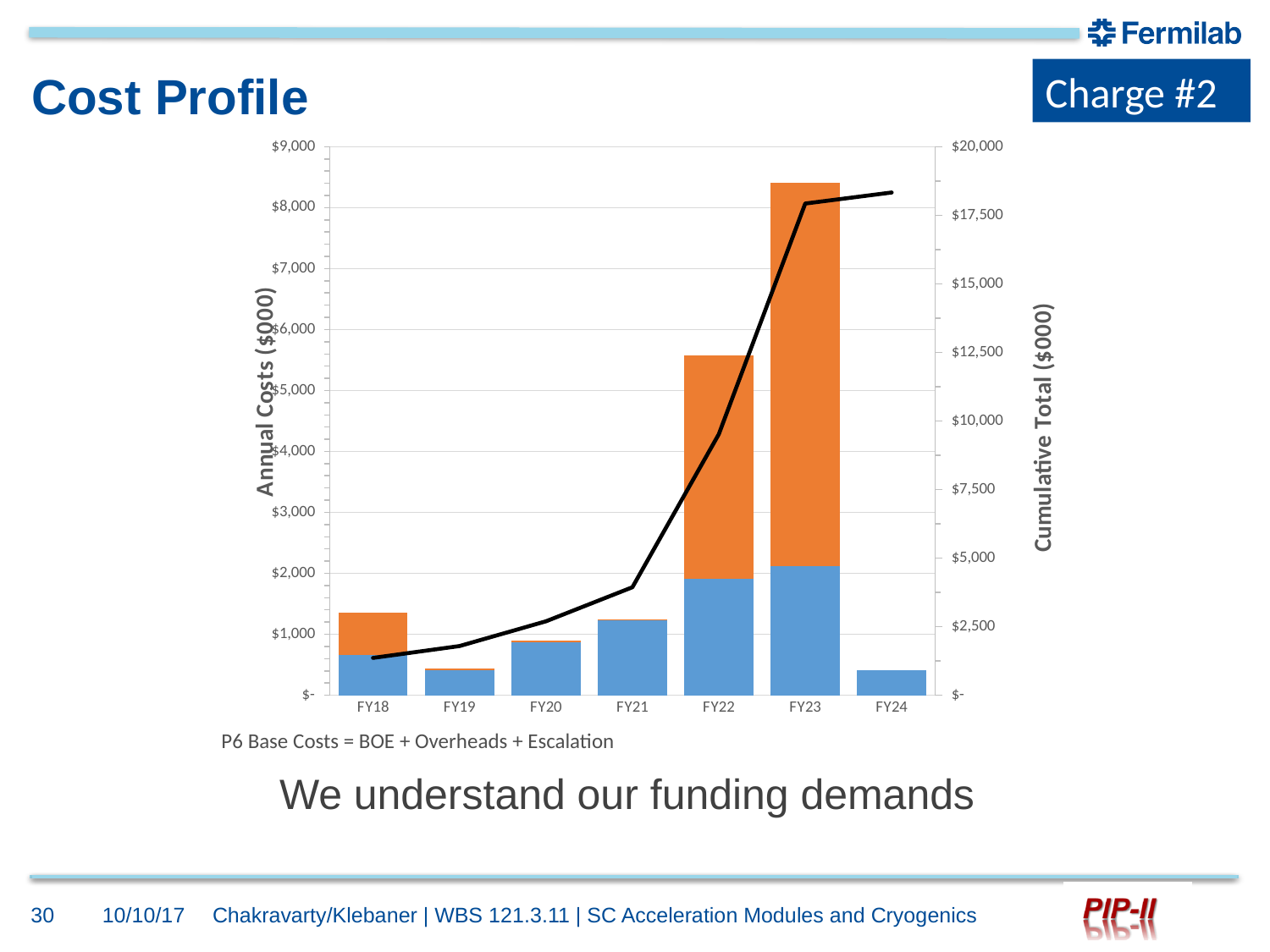
Is the total annual cost bar for FY23 greater or less than $8,000? greater How many fiscal years are shown on the x axis of the chart? 7 Is the annual cost bar for FY24 greater or less than $1,000? less Is the annual cost bar for FY20 greater or less than $1,000? less Which has the larger annual cost bar, FY18 or FY20? FY18 What is the title of the right-hand vertical axis? Cumulative Total ($000) Does the cumulative total line rise or fall from FY18 to FY24? rise What kind of chart is shown on the slide? A stacked bar chart with a line Which fiscal year has the tallest bar for annual costs? FY23 Which has the larger annual cost bar, FY21 or FY22? FY22